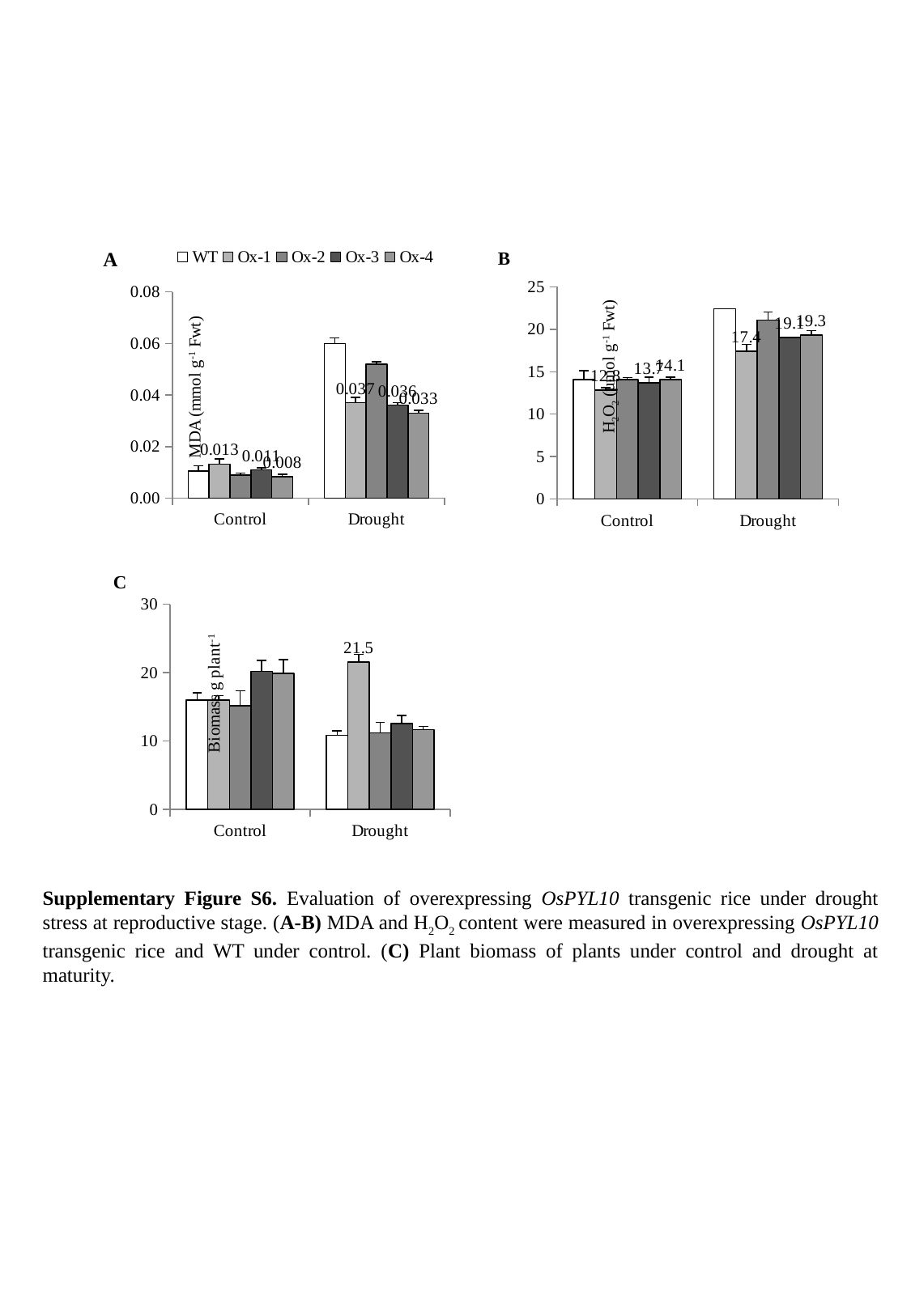
In chart B (H2O2), what is the value for Ox-4 under Control? 14.1 In chart A (MDA), is the value for WT under Drought greater or less than 0.04? greater In chart B (H2O2), what is the difference between the Ox-4 and Ox-1 values under Drought? 1.9 How many series does the legend above chart A list? 5 In chart A (MDA), what is the value for Ox-4 under Control? 0.008 In chart C (Biomass), what is the value for Ox-1 under Drought? 21.5 What kind of chart is chart A (MDA)? bar chart In chart B (H2O2), what is the value for Ox-1 under Drought? 17.4 In chart C (Biomass), which series has the highest value under Drought? Ox-1 In chart A (MDA), what is the difference between the Ox-1 value under Drought and the Ox-1 value under Control? 0.024 In chart A (MDA), which is larger under Drought, WT or Ox-1? WT In chart A (MDA), what is the value for Ox-1 under Drought? 0.037